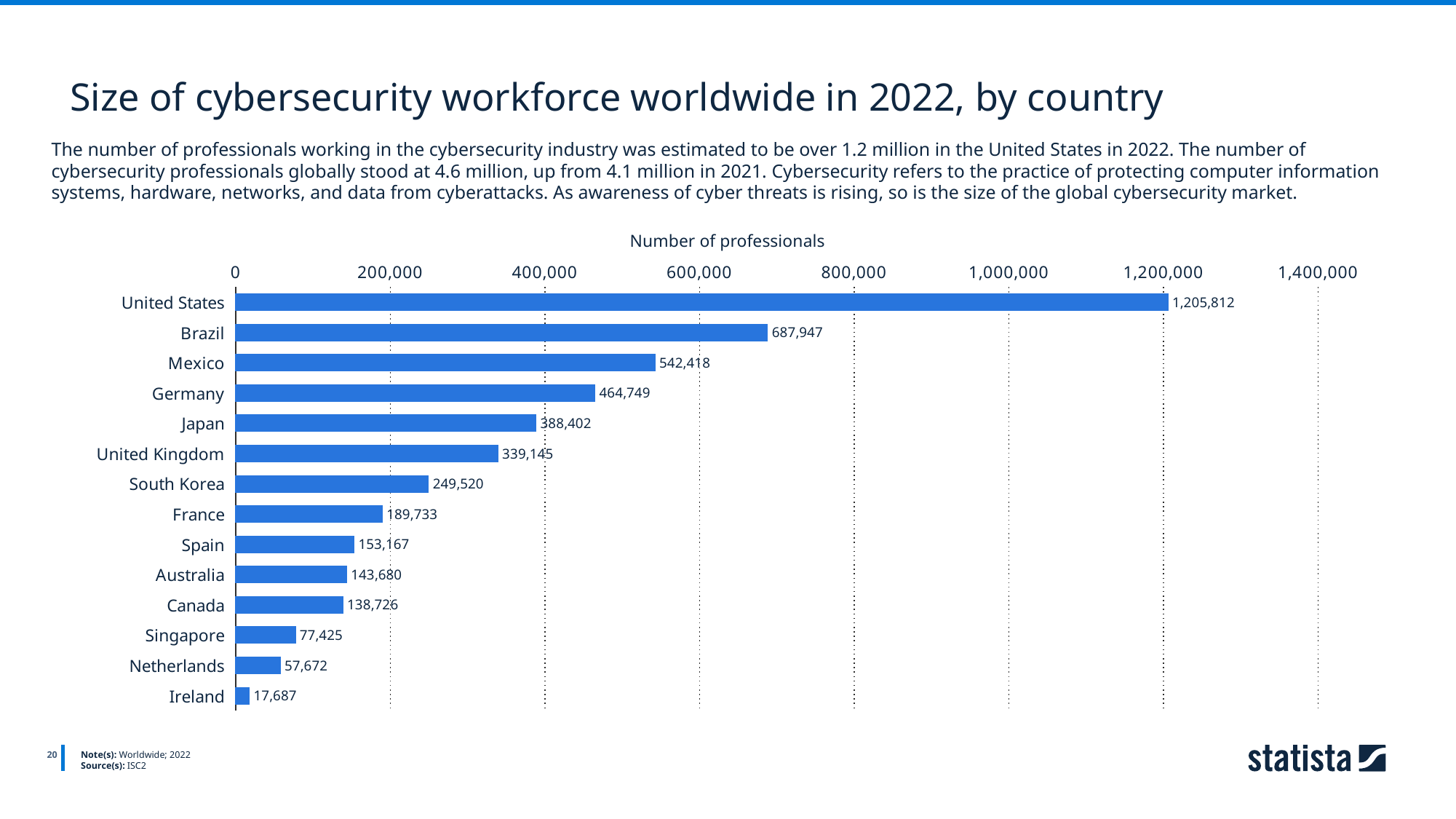
What is the number of cybersecurity professionals in Singapore? 77,425 Which has more cybersecurity professionals, South Korea or France? South Korea What is the difference between the number of professionals in Mexico and Germany? 77,669 What is the difference between the number of professionals in the United States and Brazil? 517,865 How many countries are shown in the chart? 14 Is the value for the United Kingdom greater or less than 400,000? less What kind of chart is shown on the slide? Bar chart What is the number of cybersecurity professionals in Japan? 388,402 What is the number of cybersecurity professionals in Brazil? 687,947 Which country has the smallest cybersecurity workforce? Ireland Which country has the largest cybersecurity workforce? United States What is the title of the x axis? Number of professionals